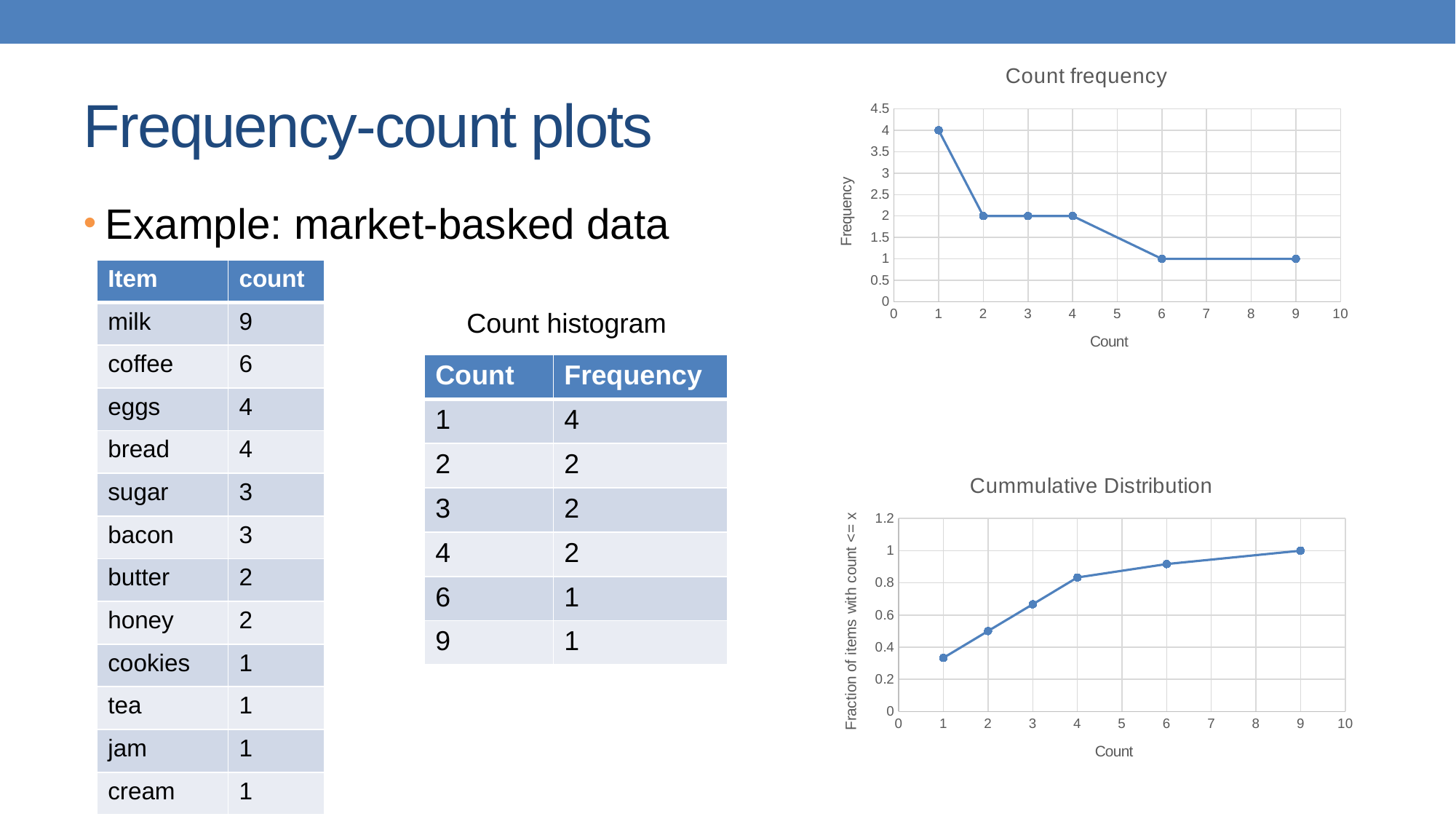
In the Cummulative Distribution chart, what is the value at count 9? 1 In the Count frequency chart, what is the difference between the frequency at count 1 and the frequency at count 4? 2 What kind of chart is the Count frequency chart? line chart In the Count frequency chart, what is the frequency for count 6? 1 In the Count frequency chart, which count has the highest frequency? 1 In the Count frequency chart, how many data points are plotted? 6 In the Cummulative Distribution chart, is the value at count 1 greater or less than 0.4? less In the Cummulative Distribution chart, do the values rise or fall as count increases? rise In the Count frequency chart, do the frequency values rise or fall as count increases? fall In the Count frequency chart, what is the frequency for count 1? 4 In the Cummulative Distribution chart, is the value at count 4 greater or less than 0.8? greater What is the y-axis label of the Cummulative Distribution chart? Fraction of items with count <= x